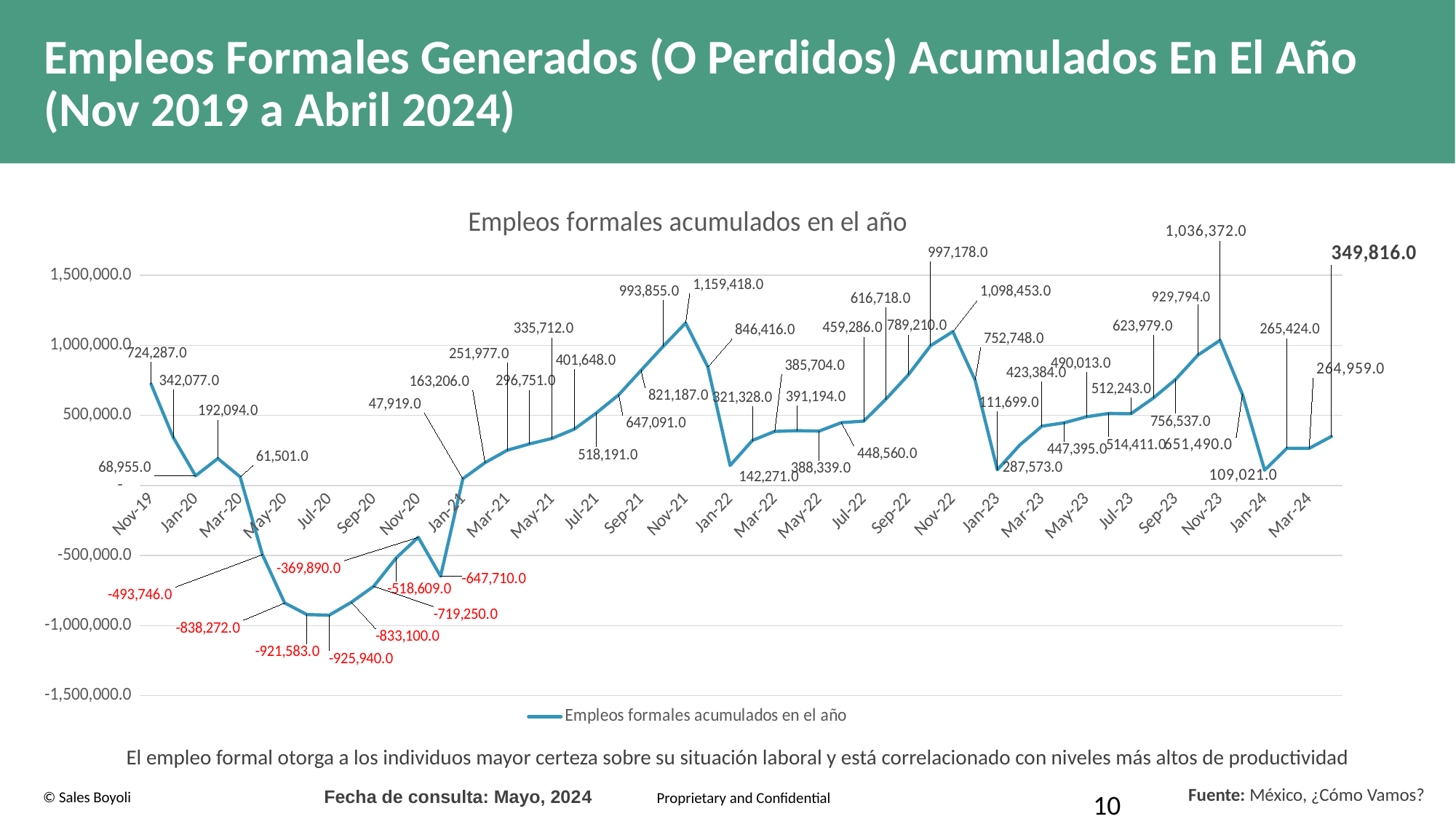
Which is larger, the Nov-21 peak or the Nov-22 peak? Nov-21 Is the value for Jul-20 greater or less than -500,000.0? less What is the value at the Nov-23 peak? 1,036,372.0 What is the highest value plotted on the chart, and in which month does it occur? 1,159,418.0 in Nov-21 Do the values rise or fall from Jan-21 to Nov-21? rise What is the value for Nov-19, the first point on the chart? 724,287.0 What is the lowest value plotted on the chart, and in which month does it occur? -925,940.0 in Jul-20 What is the value of the last point on the chart (Apr-24), shown in bold? 349,816.0 What is the title of the chart? Empleos formales acumulados en el año What is the difference between the highest value (1,159,418.0) and the lowest value (-925,940.0)? 2,085,358.0 How many series does the legend list? 1 What type of chart is shown on the slide? line chart